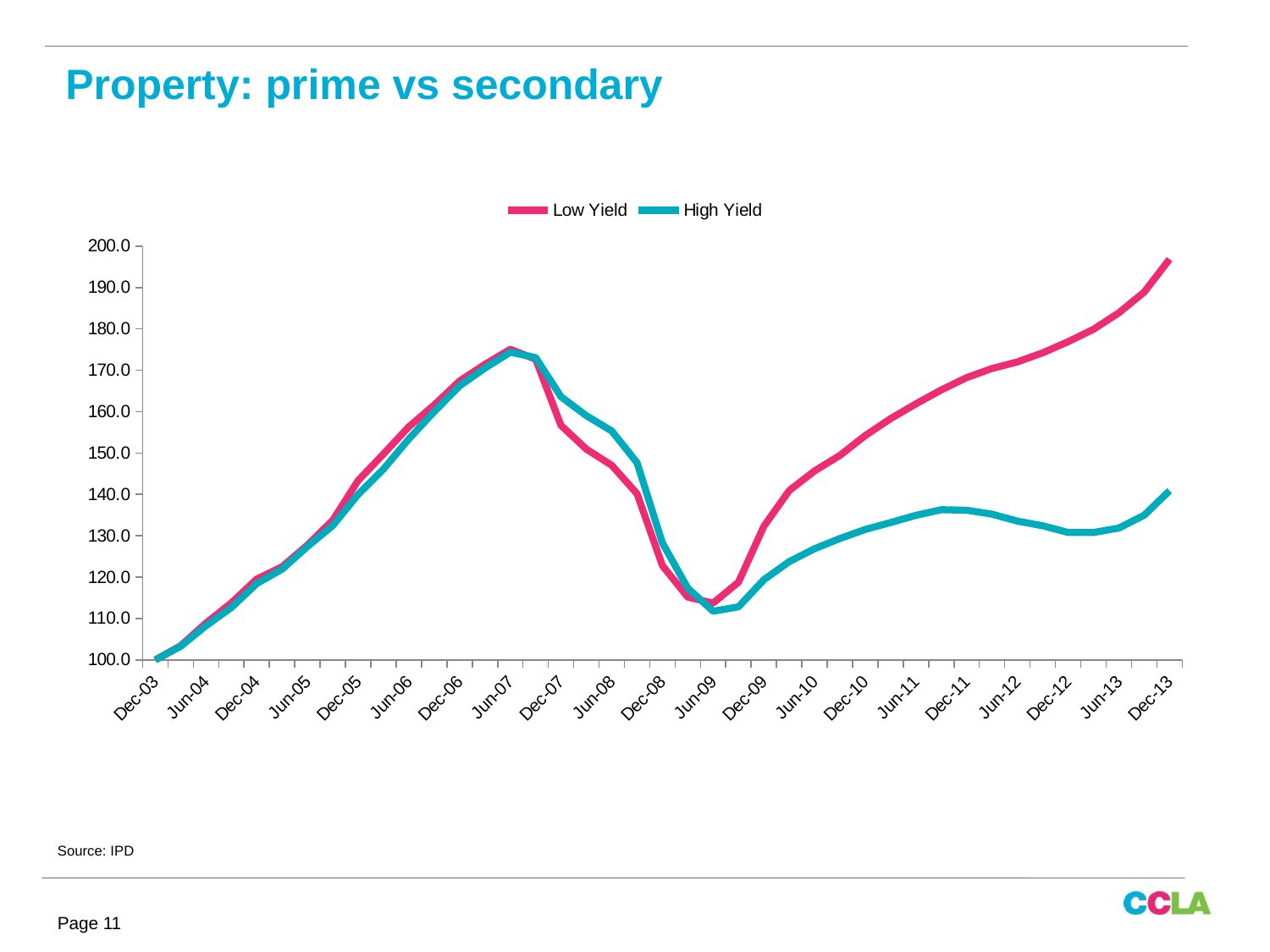
What kind of chart is shown on the slide? line chart Does the Low Yield line rise or fall between Jun-09 and Dec-13? rise How many date labels are shown along the x axis? 21 Which colour is used for the High Yield line? teal Is the value for High Yield at Dec-13 greater or less than 130.0? greater Is the value for Low Yield at Dec-11 greater or less than 160.0? greater How many series does the legend list? 2 What value do both series start at in Dec-03? 100.0 Is the value for Low Yield at Dec-13 greater or less than 190.0? greater At Dec-13, which series has the higher value, Low Yield or High Yield? Low Yield What are the two series named in the legend? Low Yield and High Yield